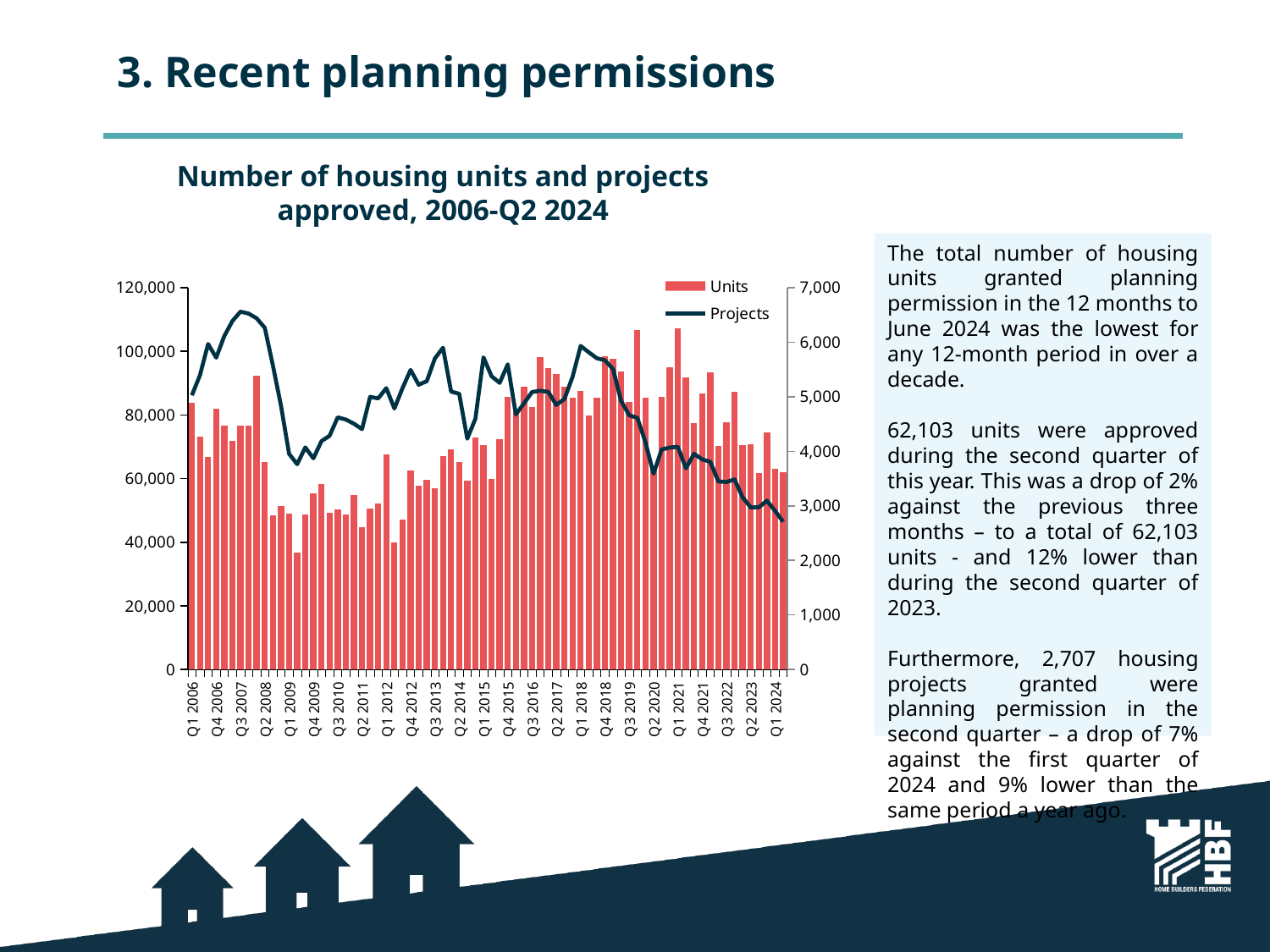
Does the Projects line rise or fall between Q1 2018 and Q1 2024? fall How many series does the chart legend list? 2 What kind of chart is shown on the slide? Combined bar and line chart Which is larger, the Projects value for Q3 2007 or for Q1 2024? Q3 2007 Which is larger, the Units value for Q1 2006 or for Q1 2009? Q1 2006 Is the Projects value for Q3 2007 greater or less than 6,000? greater Is the Units value for Q1 2024 greater or less than 80,000? less Is the Projects value for Q1 2024 greater or less than 4,000? less Which series is drawn as a line in the chart? Projects What is the title of the chart? Number of housing units and projects approved, 2006-Q2 2024